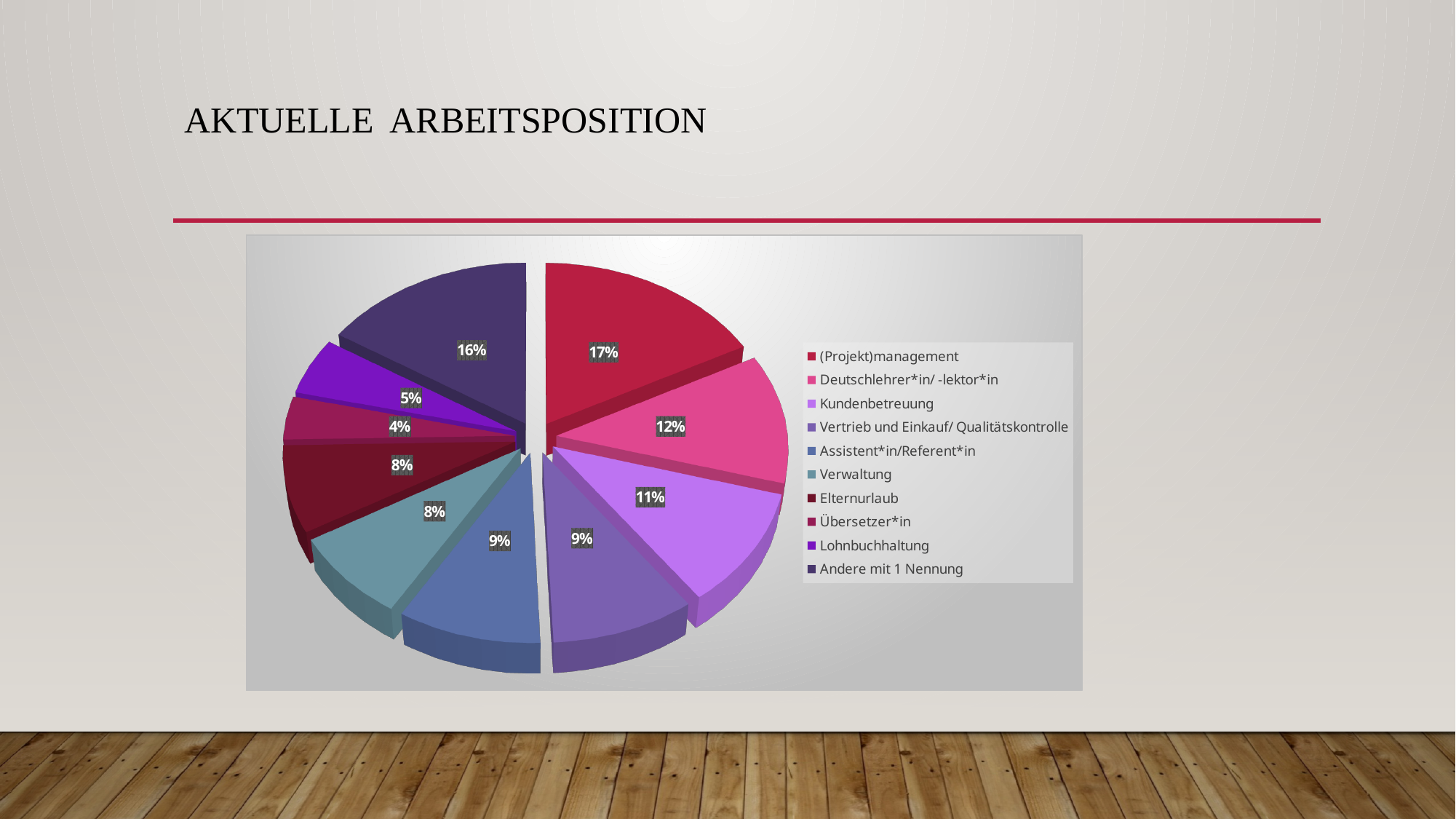
Which category has the largest share of the pie? (Projekt)management Which category has the smallest share of the pie? Übersetzer*in Which is larger, the share for Kundenbetreuung or the share for Verwaltung? Kundenbetreuung What is the value shown for Lohnbuchhaltung? 5% What share of the pie does (Projekt)management have? 17% What is the value shown for Andere mit 1 Nennung? 16% How many categories does the pie chart have? 10 What is the difference between the shares of (Projekt)management and Andere mit 1 Nennung? 1% What is the value shown for Deutschlehrer*in/ -lektor*in? 12% What kind of chart is shown on the slide? pie chart What is the value shown for Kundenbetreuung? 11% What is the title of the slide containing the chart? Aktuelle Arbeitsposition